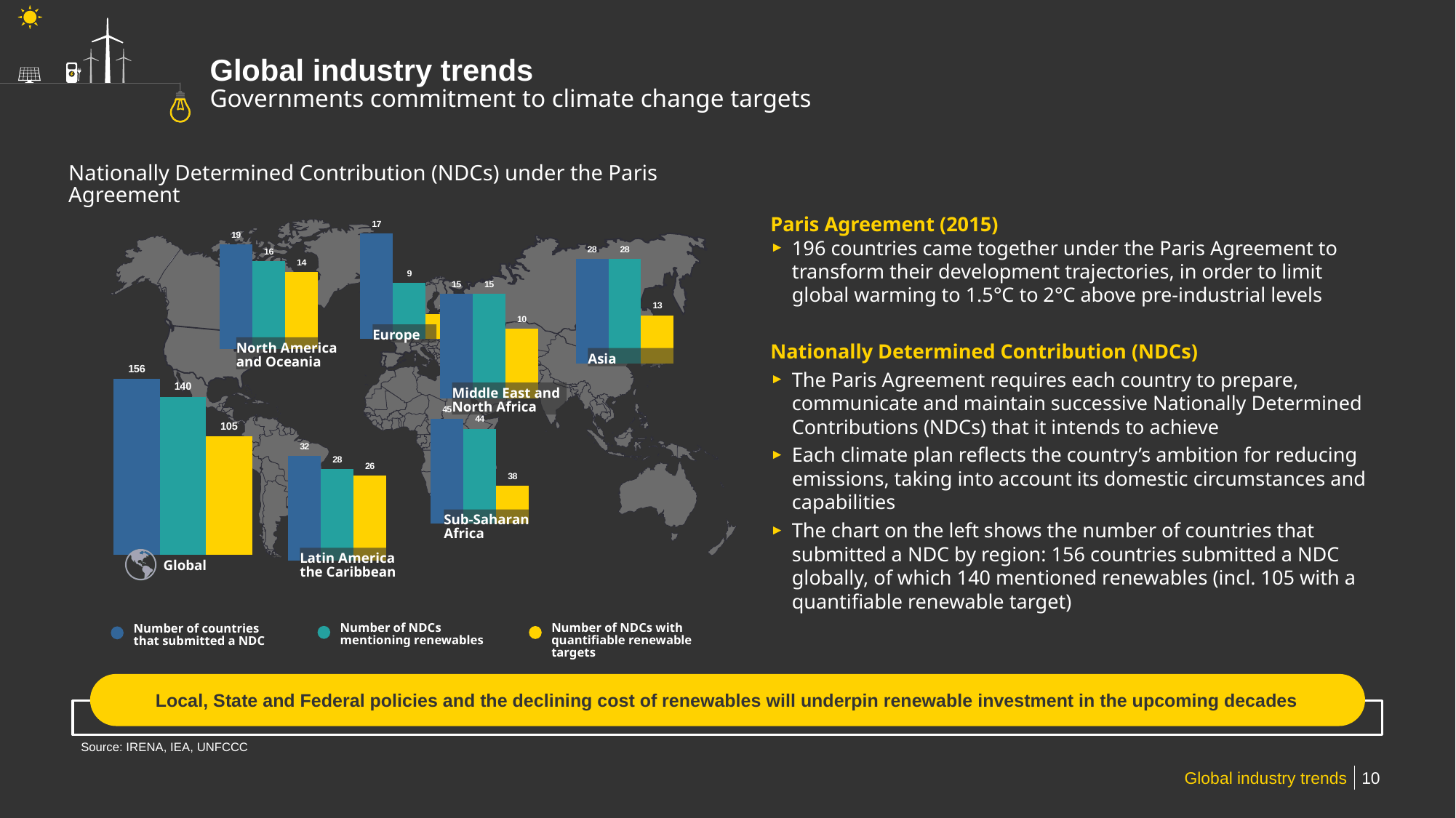
What kind of chart is used to show the NDC figures for each region? Bar chart What is the number of NDCs with quantifiable renewable targets for Asia? 13 How many series does the legend list? 3 Which is larger: the number of NDCs with quantifiable renewable targets in Latin America and the Caribbean or in North America and Oceania? Latin America and the Caribbean What is the number of countries that submitted a NDC in Latin America and the Caribbean? 32 What is the difference between the number of countries that submitted a NDC globally and the number of NDCs mentioning renewables globally? 16 Excluding the Global total, which region has the highest number of countries that submitted a NDC? Sub-Saharan Africa Which colour represents the number of NDCs with quantifiable renewable targets? Yellow What is the difference between the number of NDCs mentioning renewables and the number with quantifiable renewable targets in the Middle East and North Africa? 5 What is the number of NDCs mentioning renewables for Sub-Saharan Africa? 44 Excluding the Global total, which region has the lowest number of NDCs mentioning renewables? Europe How many countries submitted a NDC globally according to the chart? 156